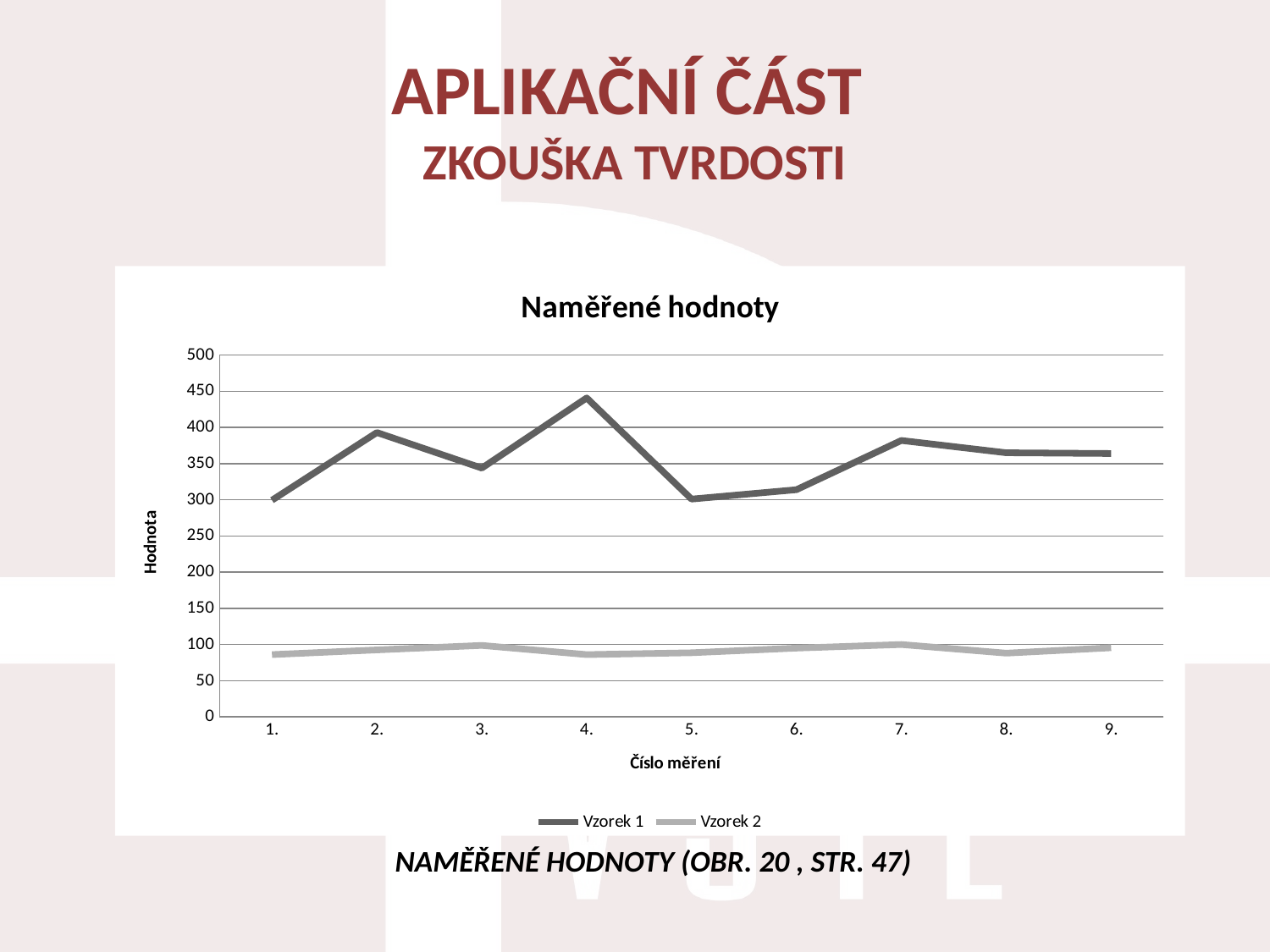
Is the value of Vzorek 1 at measurement 2 greater or less than 350? greater Is the value of Vzorek 1 at measurement 5 greater or less than 350? less What kind of chart is shown on the slide? line chart What is the title of the chart? Naměřené hodnoty Which series has higher values throughout the chart, Vzorek 1 or Vzorek 2? Vzorek 1 Is the value of Vzorek 2 at measurement 1 greater or less than 100? less How many measurement points are plotted along the x axis? 9 Does the value of Vzorek 1 rise or fall from measurement 4 to measurement 5? fall Which is larger for Vzorek 1: the value at measurement 2 or at measurement 3? measurement 2 At which measurement number does Vzorek 1 reach its highest value? 4. How many series does the legend list? 2